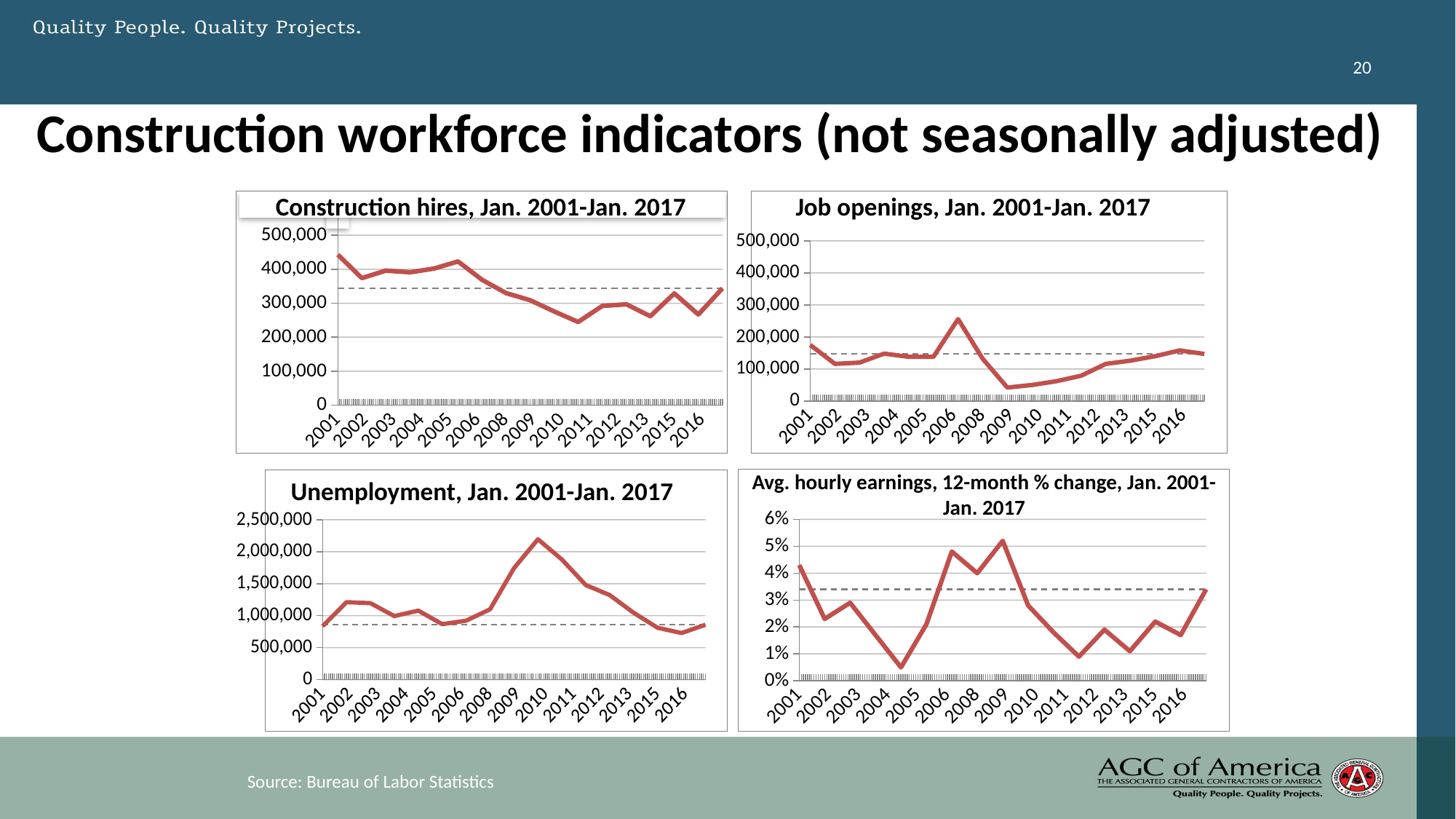
In the 'Unemployment, Jan. 2001-Jan. 2017' chart, is the value for 2010 greater or less than 2,000,000? greater How many charts are shown on the slide? 4 In the 'Unemployment, Jan. 2001-Jan. 2017' chart, is the value for 2001 greater or less than 1,000,000? less In the 'Construction hires, Jan. 2001-Jan. 2017' chart, is the value for 2001 greater or less than 400,000? greater In the 'Unemployment, Jan. 2001-Jan. 2017' chart, do values rise or fall from 2010 to 2015? fall What kind of chart is the 'Construction hires, Jan. 2001-Jan. 2017' chart? line chart In the 'Unemployment, Jan. 2001-Jan. 2017' chart, which year shows the highest value? 2010 What is the title of the bottom-right chart? Avg. hourly earnings, 12-month % change, Jan. 2001-Jan. 2017